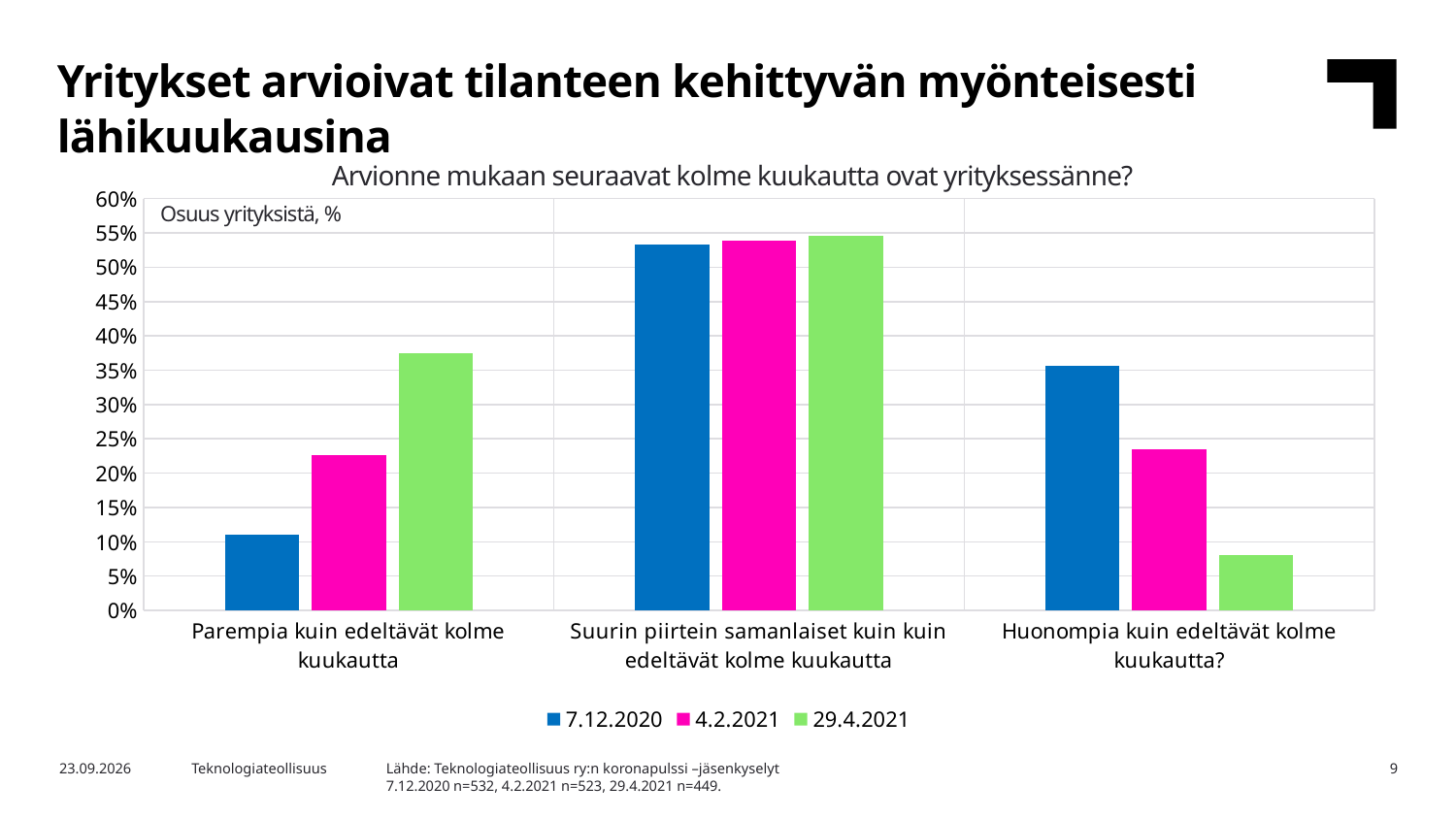
Is the value for 29.4.2021 in the category "Huonompia kuin edeltävät kolme kuukautta?" greater or less than 10%? less How many series does the legend list? 3 Across the three survey dates, do the values in the category "Parempia kuin edeltävät kolme kuukautta" rise or fall? rise Is the value for 7.12.2020 in the category "Huonompia kuin edeltävät kolme kuukautta?" greater or less than 30%? greater Which survey date has the highest value in the category "Parempia kuin edeltävät kolme kuukautta"? 29.4.2021 What is the title of the chart? Arvionne mukaan seuraavat kolme kuukautta ovat yrityksessänne? What kind of chart is shown on the slide? bar chart In the category "Huonompia kuin edeltävät kolme kuukautta?", which is larger: the value for 7.12.2020 or for 4.2.2021? 7.12.2020 How many categories are shown on the x axis? 3 Which survey date has the lowest value in the category "Huonompia kuin edeltävät kolme kuukautta?"? 29.4.2021 Is the value for 7.12.2020 in the category "Parempia kuin edeltävät kolme kuukautta" greater or less than 15%? less